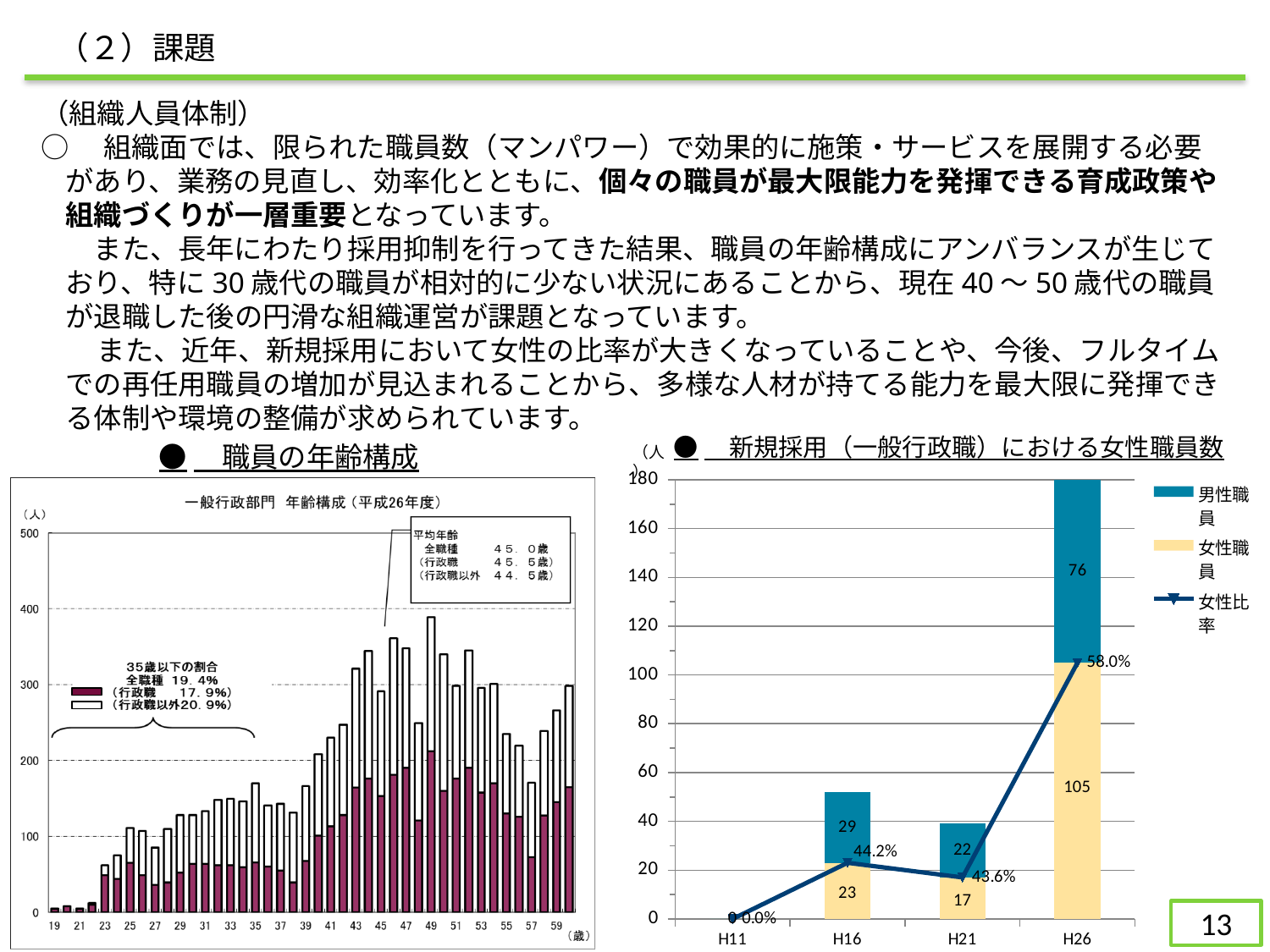
In the chart titled 新規採用（一般行政職）における女性職員数, what is the value for 男性職員 in H16? 29 What kind of chart is the one on the left titled 職員の年齢構成? Bar chart In the chart titled 新規採用（一般行政職）における女性職員数, how many years are shown on the x axis? 4 In the chart titled 新規採用（一般行政職）における女性職員数, how many series does the legend list? 3 In the chart titled 新規採用（一般行政職）における女性職員数, what is the value for 女性職員 in H26? 105 In the chart titled 新規採用（一般行政職）における女性職員数, what is the total of the stacked bar for H21? 39 In the chart titled 新規採用（一般行政職）における女性職員数, what is the difference between 女性職員 in H26 and 女性職員 in H16? 82 In the chart titled 新規採用（一般行政職）における女性職員数, which year has the highest value for 女性職員? H26 In the chart titled 新規採用（一般行政職）における女性職員数, which is larger in H26: 男性職員 or 女性職員? 女性職員 In the chart titled 新規採用（一般行政職）における女性職員数, what is the total of the stacked bar for H26? 181 In the chart titled 新規採用（一般行政職）における女性職員数, what is the 女性比率 for H21? 43.6% In the chart titled 新規採用（一般行政職）における女性職員数, what is the 女性比率 for H26? 58.0%